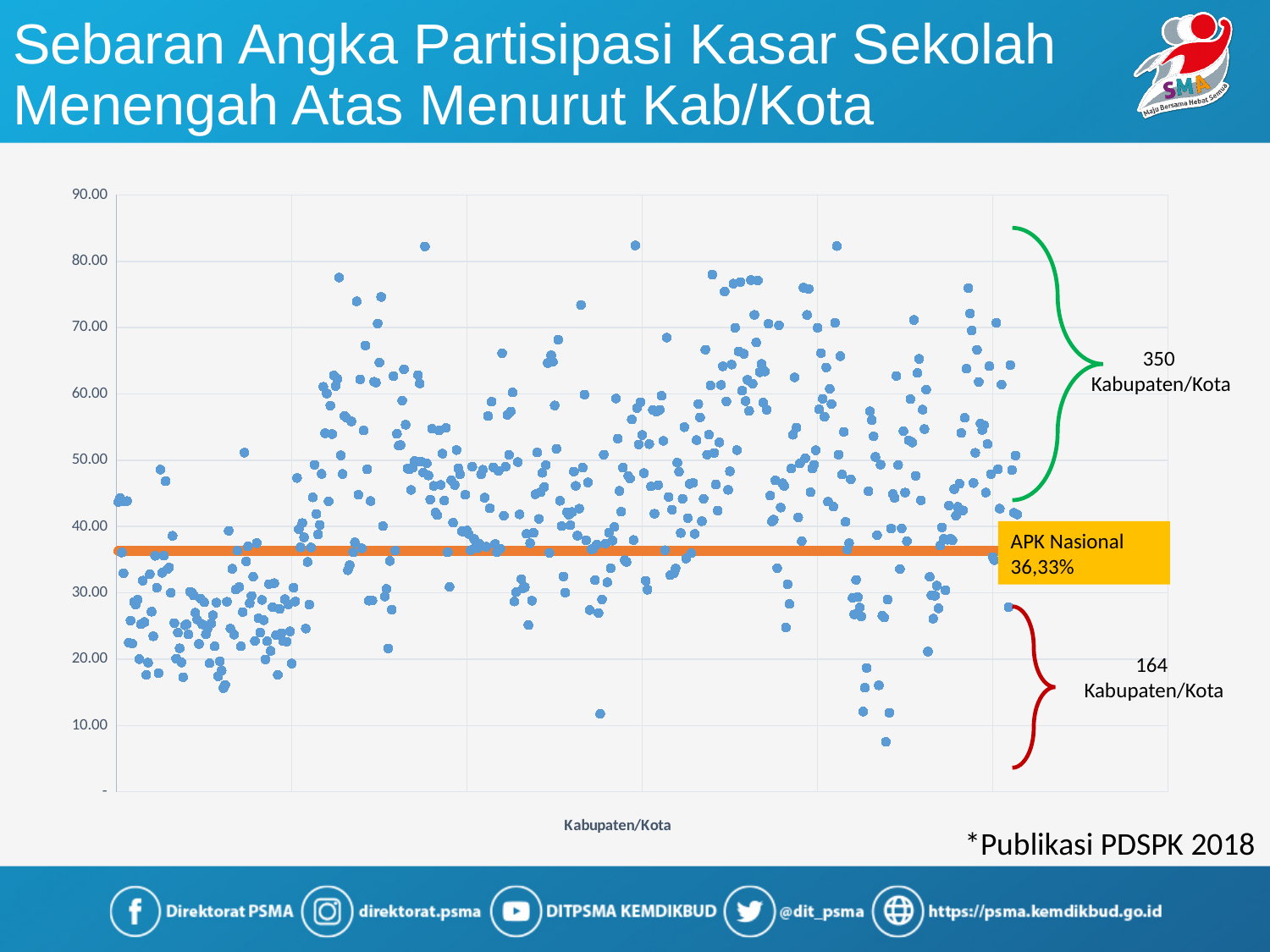
What kind of chart is shown on the slide? Scatter chart According to the annotation, how many Kabupaten/Kota lie above the APK Nasional line? 350 Kabupaten/Kota According to the annotation, how many Kabupaten/Kota lie below the APK Nasional line? 164 Kabupaten/Kota What is the highest tick value shown on the vertical axis? 90.00 What is the label of the horizontal axis? Kabupaten/Kota Is the highest plotted point on the chart greater or less than 80.00? greater What is the difference between the number of Kabupaten/Kota above and below the APK Nasional line? 186 What is the APK Nasional value marked by the horizontal line on the chart? 36,33% Are there more Kabupaten/Kota above or below the APK Nasional line? Above What is the total number of Kabupaten/Kota plotted, based on the two annotated counts? 514 Is the lowest plotted point on the chart greater or less than 10.00? less